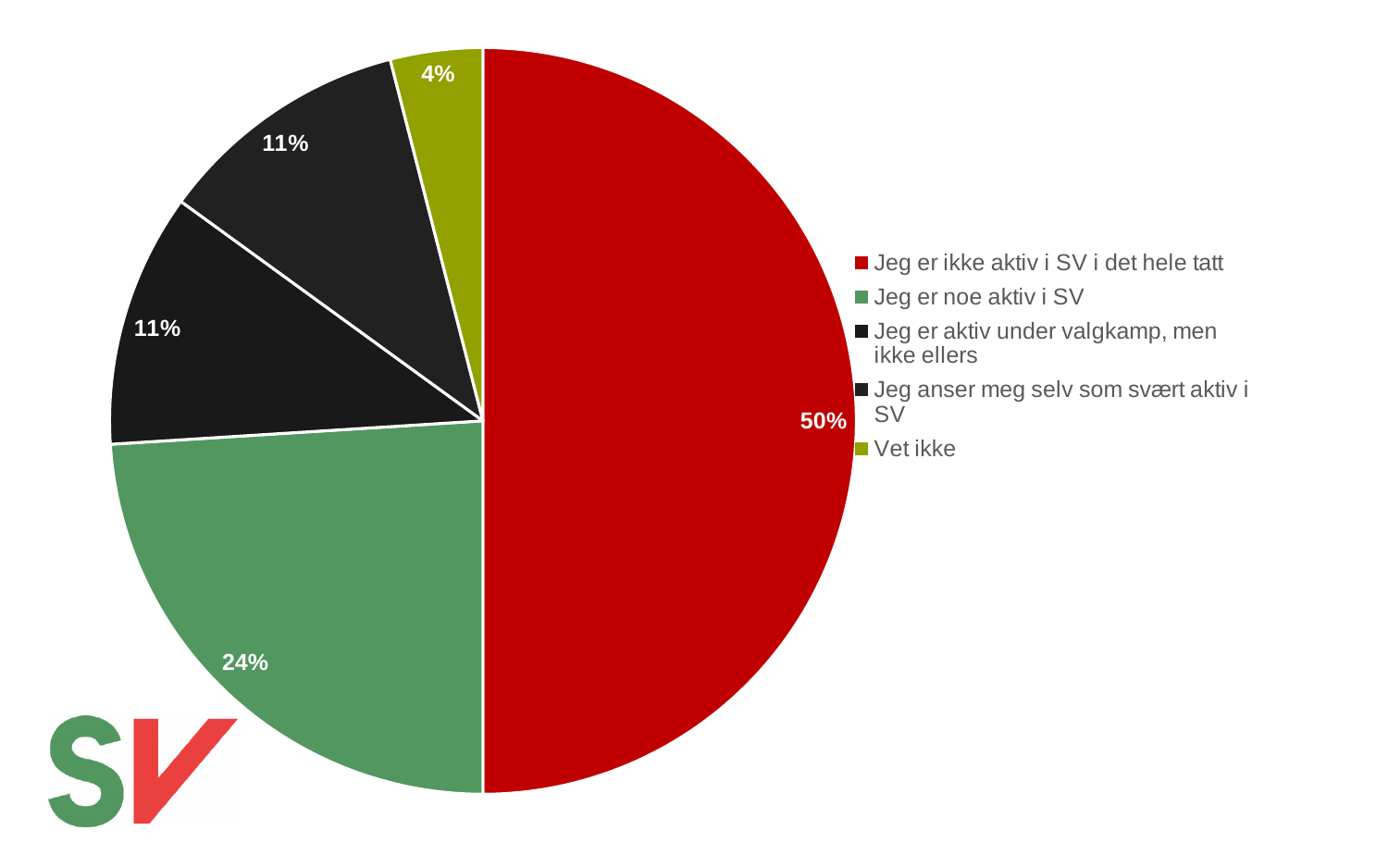
Which category has the smallest share of the pie? Vet ikke How many slices does the pie chart have? 5 What percentage of respondents answered "Vet ikke"? 4% What is the difference in percentage points between "Jeg er ikke aktiv i SV i det hele tatt" and "Jeg er noe aktiv i SV"? 26 percentage points Which is larger: the share for "Jeg er noe aktiv i SV" or the share for "Vet ikke"? Jeg er noe aktiv i SV What percentage of respondents answered "Jeg er ikke aktiv i SV i det hele tatt"? 50% What percentage of respondents answered "Jeg anser meg selv som svært aktiv i SV"? 11% What colour is the slice for "Jeg er ikke aktiv i SV i det hele tatt"? red What percentage of respondents answered "Jeg er noe aktiv i SV"? 24% Which category has the largest share of the pie? Jeg er ikke aktiv i SV i det hele tatt What percentage of respondents answered "Jeg er aktiv under valgkamp, men ikke ellers"? 11% What kind of chart is shown on the slide? pie chart